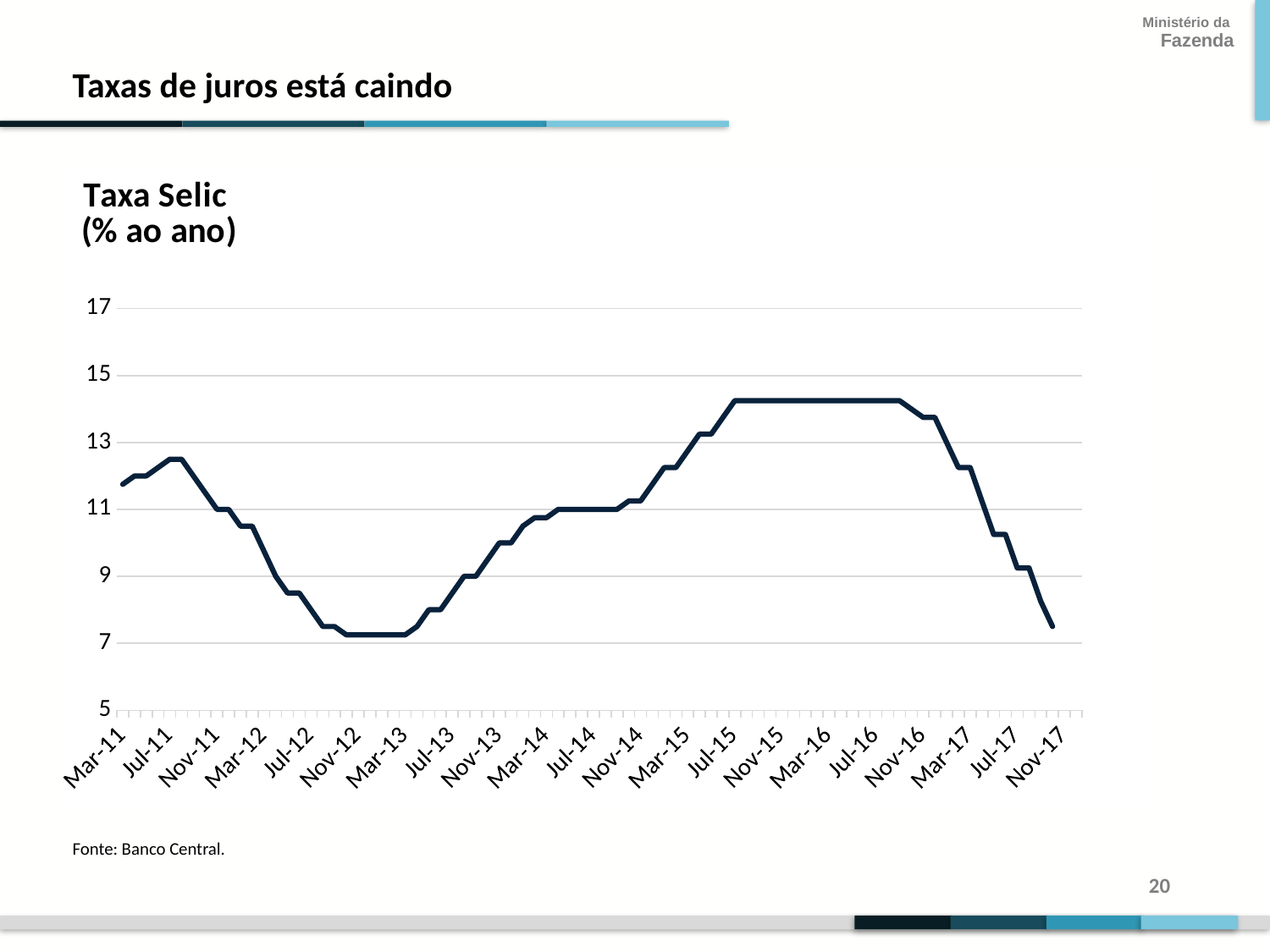
Does the Taxa Selic rise or fall between Nov-16 and Nov-17? fall Is the value for Mar-11 greater or less than 11? greater Is the value for Nov-17 greater or less than 9? less How many date labels are shown on the x axis? 21 What source is cited below the chart? Banco Central Is the value for Jul-17 greater or less than 11? less What is the title of the chart? Taxa Selic (% ao ano) What kind of chart is shown on the slide? line chart Which is larger, the value for Jul-15 or the value for Nov-12? Jul-15 Which is larger, the value for Mar-11 or the value for Nov-17? Mar-11